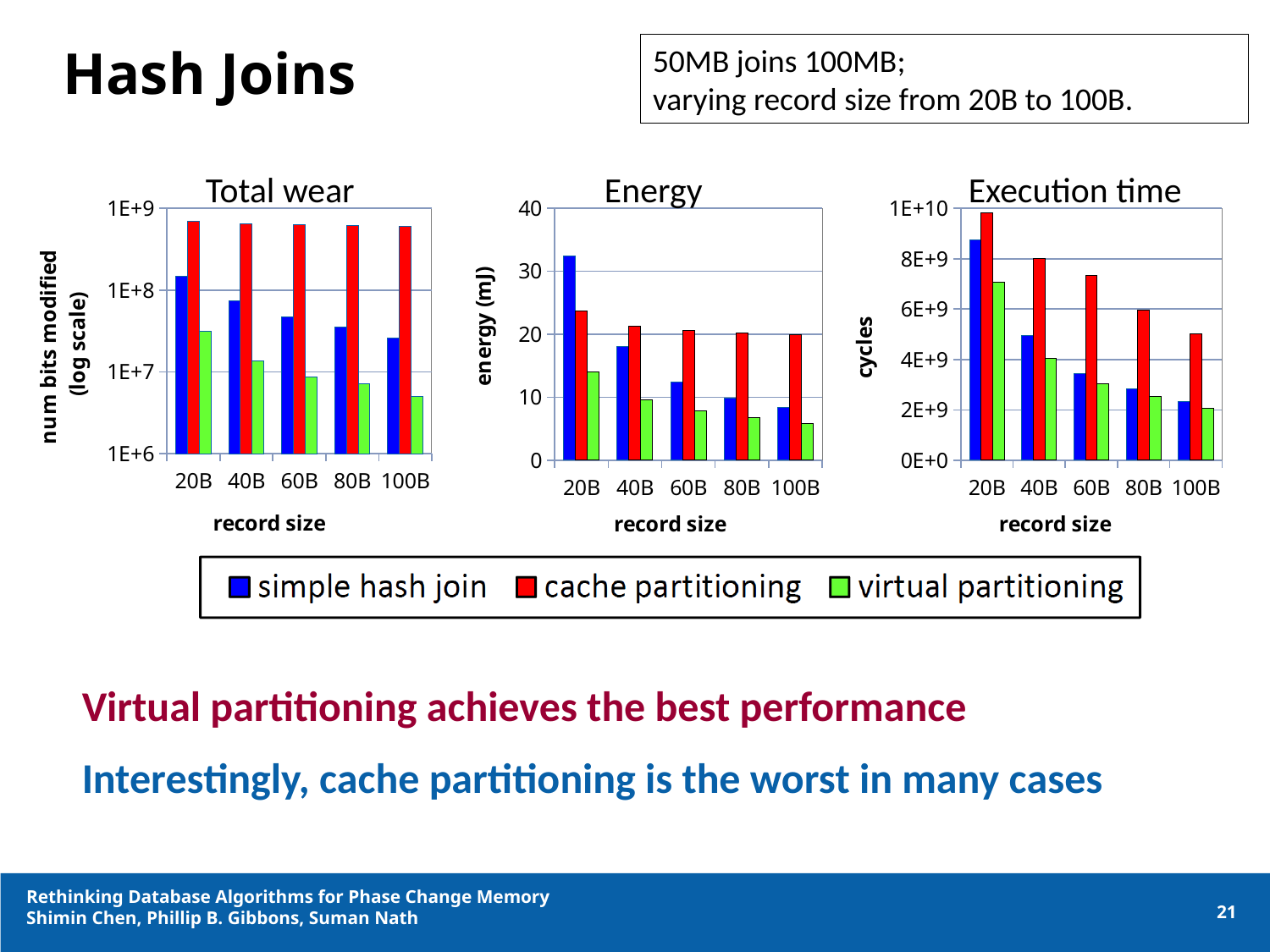
In the Energy chart, is the value for simple hash join at 100B greater or less than 10? less How many record size categories are shown on the x axis of the Energy chart? 5 In the Total wear chart, which series has the highest value at 20B? cache partitioning In the Energy chart, which series has the highest value at 20B? simple hash join What kind of chart is the Total wear chart? bar chart In the Energy chart, is the value for simple hash join at 20B greater or less than 30? greater In the Execution time chart, which is larger at 60B: cache partitioning or virtual partitioning? cache partitioning How many series does the legend list for the charts? 3 In the Total wear chart, is the value for virtual partitioning at 100B greater or less than 1E+7? less In the Execution time chart, which series has the lowest value at 20B? virtual partitioning In the Energy chart, do the values for simple hash join rise or fall as record size increases from 20B to 100B? fall